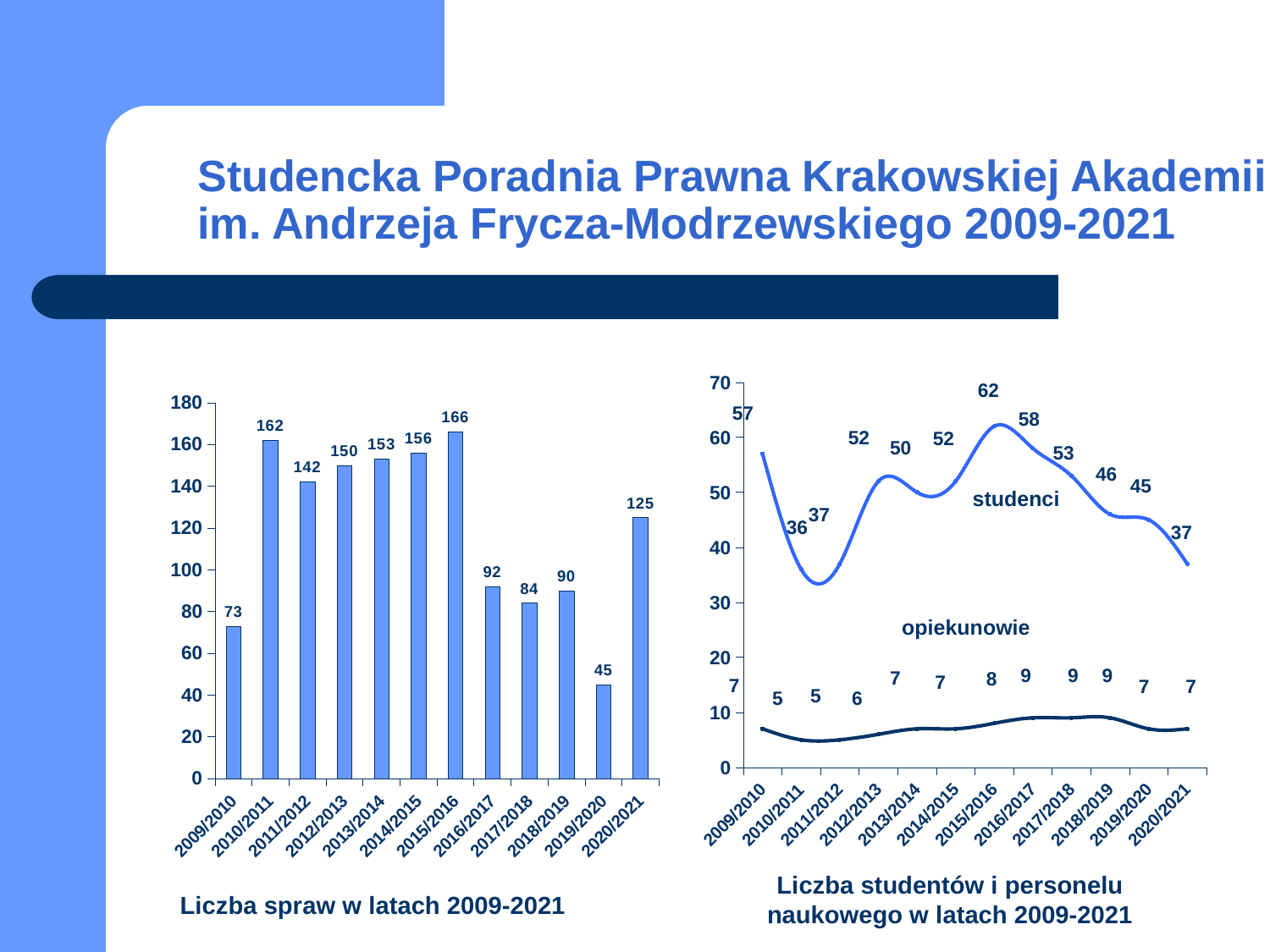
What kind of chart is 'Liczba spraw w latach 2009-2021'? bar chart What kind of chart is 'Liczba studentów i personelu naukowego w latach 2009-2021'? line chart In the chart 'Liczba studentów i personelu naukowego w latach 2009-2021', what is the value for studenci in 2015/2016? 62 In the chart 'Liczba studentów i personelu naukowego w latach 2009-2021', how many series are plotted? 2 In the chart 'Liczba spraw w latach 2009-2021', which year has the highest value? 2015/2016 In the chart 'Liczba spraw w latach 2009-2021', what is the value for 2015/2016? 166 In the chart 'Liczba spraw w latach 2009-2021', how many years are shown on the x axis? 12 In the chart 'Liczba studentów i personelu naukowego w latach 2009-2021', is the value for studenci in 2009/2010 larger or the value in 2020/2021? 2009/2010 In the chart 'Liczba spraw w latach 2009-2021', which year has the lowest value? 2019/2020 In the chart 'Liczba spraw w latach 2009-2021', what is the difference between the values for 2020/2021 and 2019/2020? 80 In the chart 'Liczba studentów i personelu naukowego w latach 2009-2021', what is the value for opiekunowie in 2016/2017? 9 In the chart 'Liczba studentów i personelu naukowego w latach 2009-2021', which year has the lowest value for studenci? 2010/2011